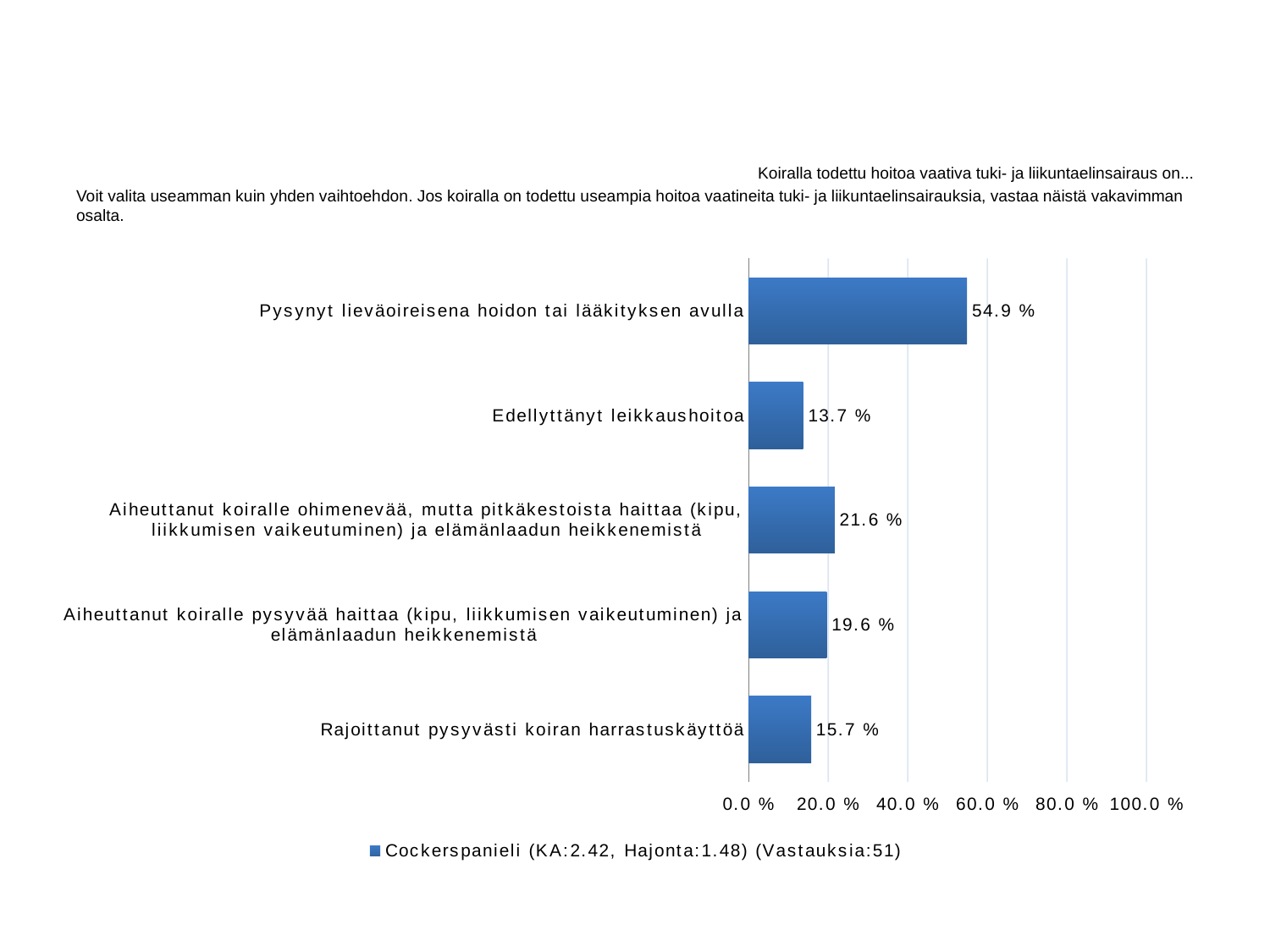
What is the difference between the values for "Pysynyt lieväoireisena hoidon tai lääkityksen avulla" and "Edellyttänyt leikkaushoitoa"? 41.2 % How many responses (Vastauksia) does the legend entry report? 51 How many categories are shown in the chart? 5 What is the value for "Edellyttänyt leikkaushoitoa"? 13.7 % Is the value for "Pysynyt lieväoireisena hoidon tai lääkityksen avulla" greater or less than 40.0 %? greater Which category has the lowest value? Edellyttänyt leikkaushoitoa What is the value for "Pysynyt lieväoireisena hoidon tai lääkityksen avulla"? 54.9 % What is the value for "Rajoittanut pysyvästi koiran harrastuskäyttöä"? 15.7 % Which category has the highest value? Pysynyt lieväoireisena hoidon tai lääkityksen avulla How many series does the legend list? 1 Which is larger: the value for "Aiheuttanut koiralle ohimenevää, mutta pitkäkestoista haittaa (kipu, liikkumisen vaikeutuminen) ja elämänlaadun heikkenemistä" or for "Rajoittanut pysyvästi koiran harrastuskäyttöä"? Aiheuttanut koiralle ohimenevää, mutta pitkäkestoista haittaa (kipu, liikkumisen vaikeutuminen) ja elämänlaadun heikkenemistä What kind of chart is shown on the slide? Bar chart